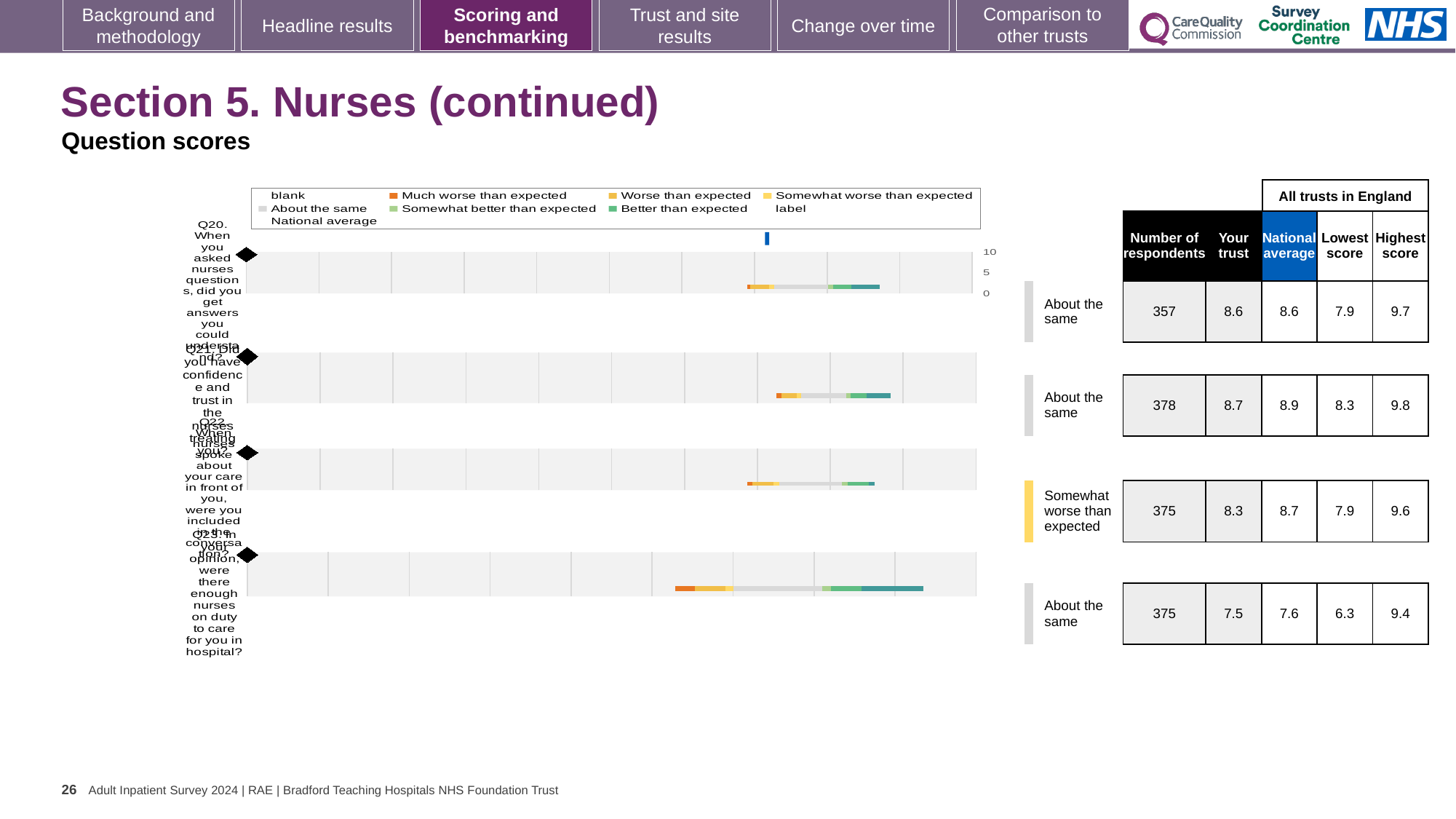
For Q21 (the second row), what is the national average score? 8.9 How many respondents answered Q23 (the bottom row)? 375 For Q21, which is larger: the 'Your trust' score or the national average? national average What kind of chart is used to show the question scores on this slide? bar chart What is the lowest score across all trusts in England for Q23? 6.3 For Q20 (the top row), what is the 'Your trust' score shown in the table? 8.6 Which question has the lowest 'Your trust' score on this slide? Q23 What is the highest score across all trusts in England for Q21? 9.8 How many questions (Q20 to Q23) are plotted on this slide? 4 Which benchmark category is Q22 (the third row) placed in? Somewhat worse than expected For Q22 (the third row), what is the difference between the national average and the 'Your trust' score? 0.4 Which question has the highest 'Your trust' score on this slide? Q21